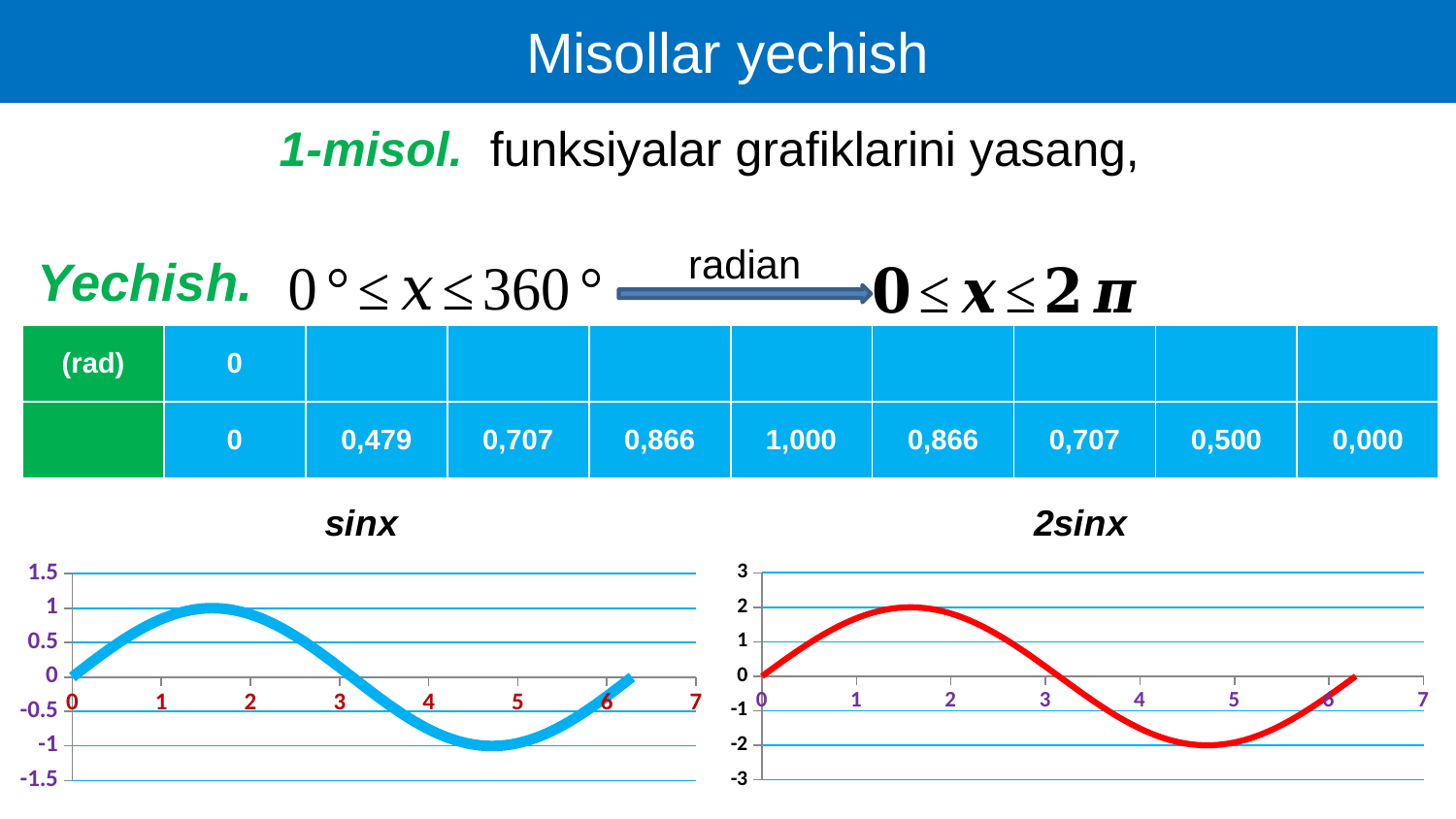
In the 2sinx chart, what is the lowest value the curve reaches? -2 In the 2sinx chart, does the curve rise or fall between x = 2 and x = 4? fall In the sinx chart, what is the highest value the curve reaches? 1 In the 2sinx chart, what is the highest value the curve reaches? 2 In the sinx chart, what is the lowest value the curve reaches? -1 What is the highest tick shown on the vertical axis of the 2sinx chart? 3 In the 2sinx chart, is the value at x = 4 greater or less than -1? less What type of chart is the 2sinx chart? line chart Which chart has the higher peak value, sinx or 2sinx? 2sinx What colour is the curve in the sinx chart? blue In the sinx chart, is the value at x = 1 greater or less than 0.5? greater What type of chart is the sinx chart? line chart